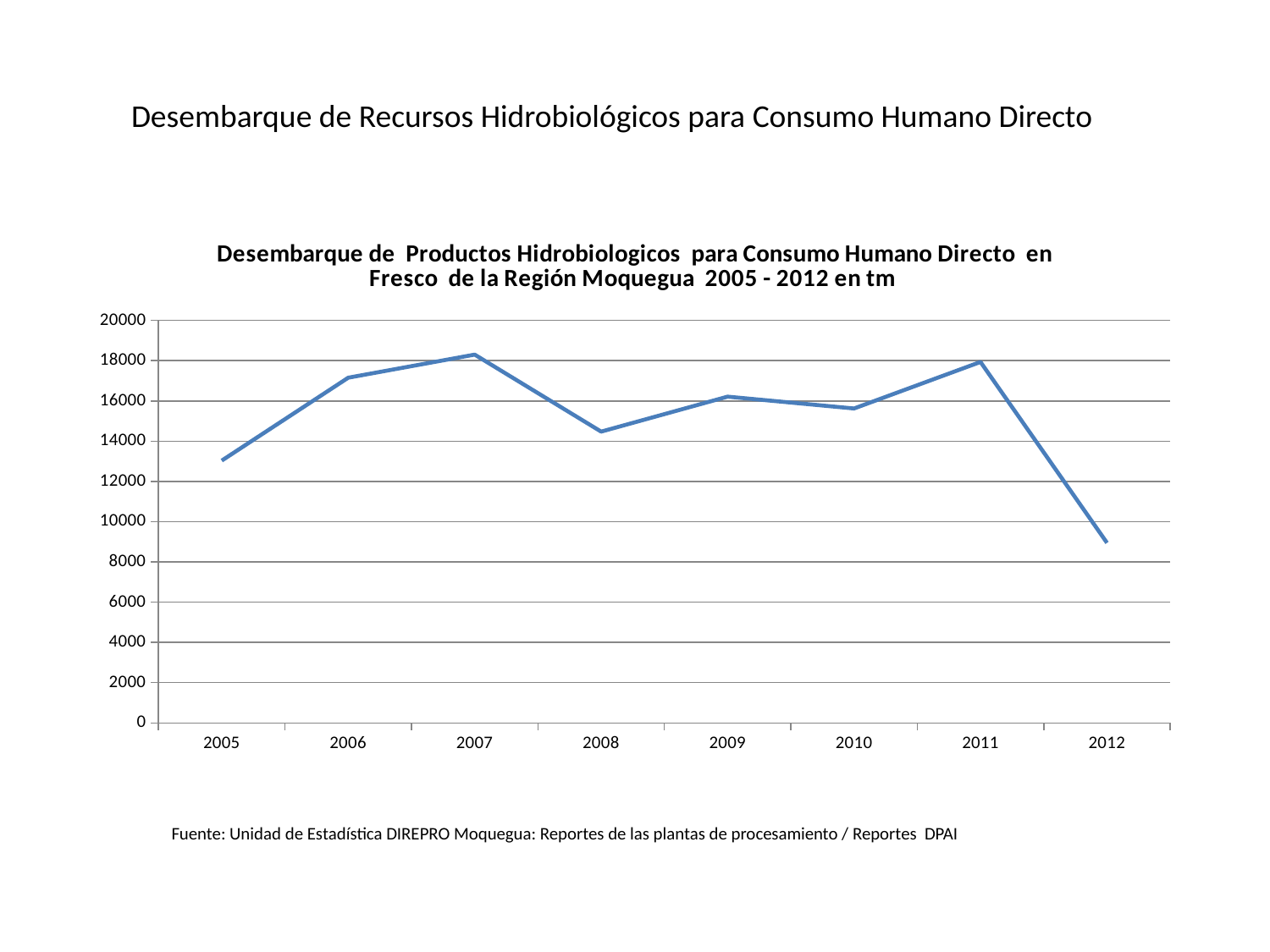
Which year has the lowest value? 2012 Is the value for 2005 greater or less than 14000? less What kind of chart is shown on the slide? line chart Which is larger, the value for 2005 or the value for 2012? 2005 Is the value for 2012 greater or less than 10000? less What is the highest value shown on the y axis? 20000 Which is larger, the value for 2006 or the value for 2008? 2006 Is the value for 2006 greater or less than 16000? greater How many years are plotted on the x axis? 8 Does the value rise or fall from 2011 to 2012? fall